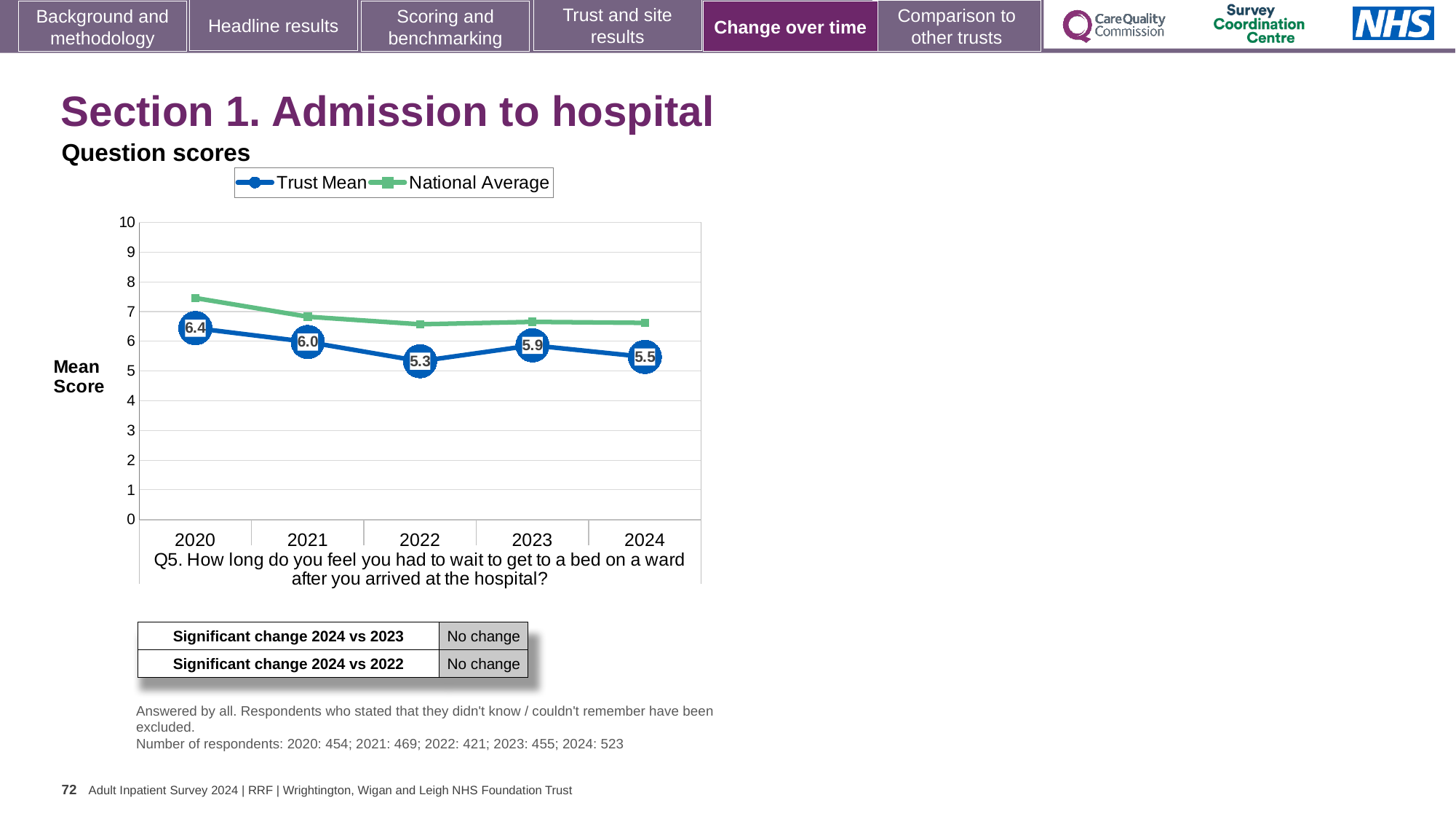
What kind of chart is shown? Line chart What is the Trust Mean score for 2022? 5.3 How many years are plotted on the x axis? 5 What is the difference between the Trust Mean scores for 2020 and 2024? 0.9 How many series does the legend list? 2 Which is larger, the Trust Mean score for 2021 or for 2023? 2021 What is the Trust Mean score for 2024? 5.5 What is the Trust Mean score for 2020? 6.4 In which year is the Trust Mean score highest? 2020 In which year is the Trust Mean score lowest? 2022 Is the National Average value for 2020 greater or less than 7? greater Is the National Average value for 2022 greater or less than 7? less